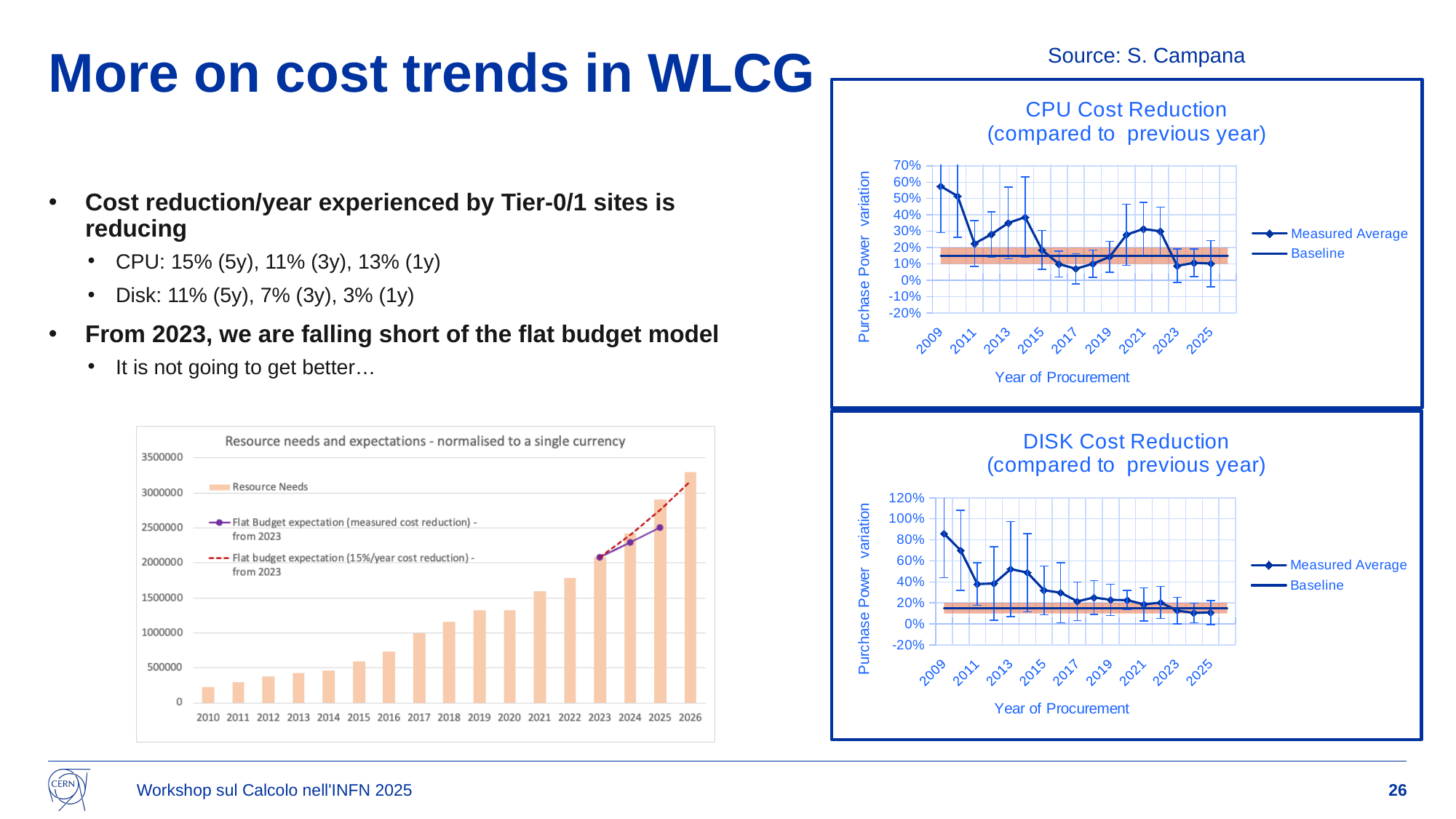
In the 'Resource needs and expectations' chart, how many series does the legend list? 3 What kind of chart is the 'Resource needs and expectations - normalised to a single currency' chart? bar chart with line series In the 'Resource needs and expectations' chart, do the Resource Needs bars rise or fall from 2010 to 2026? rise In the 'DISK Cost Reduction' chart, which year has the highest Measured Average? 2009 In the 'Resource needs and expectations' chart, which year has the highest Resource Needs bar? 2026 In the 'CPU Cost Reduction' chart, is the Measured Average for 2009 greater or less than 50%? greater In the 'DISK Cost Reduction' chart, is the Measured Average for 2025 greater or less than 20%? less In the 'Resource needs and expectations' chart, how many years (bars) are shown on the x axis? 17 In the 'CPU Cost Reduction' chart, which year has the highest Measured Average? 2009 What kind of chart is the 'CPU Cost Reduction (compared to previous year)' chart? line chart In the 'Resource needs and expectations' chart, is the Resource Needs value for 2026 greater or less than 3000000? greater In the 'Resource needs and expectations' chart, which year has the lowest Resource Needs bar? 2010